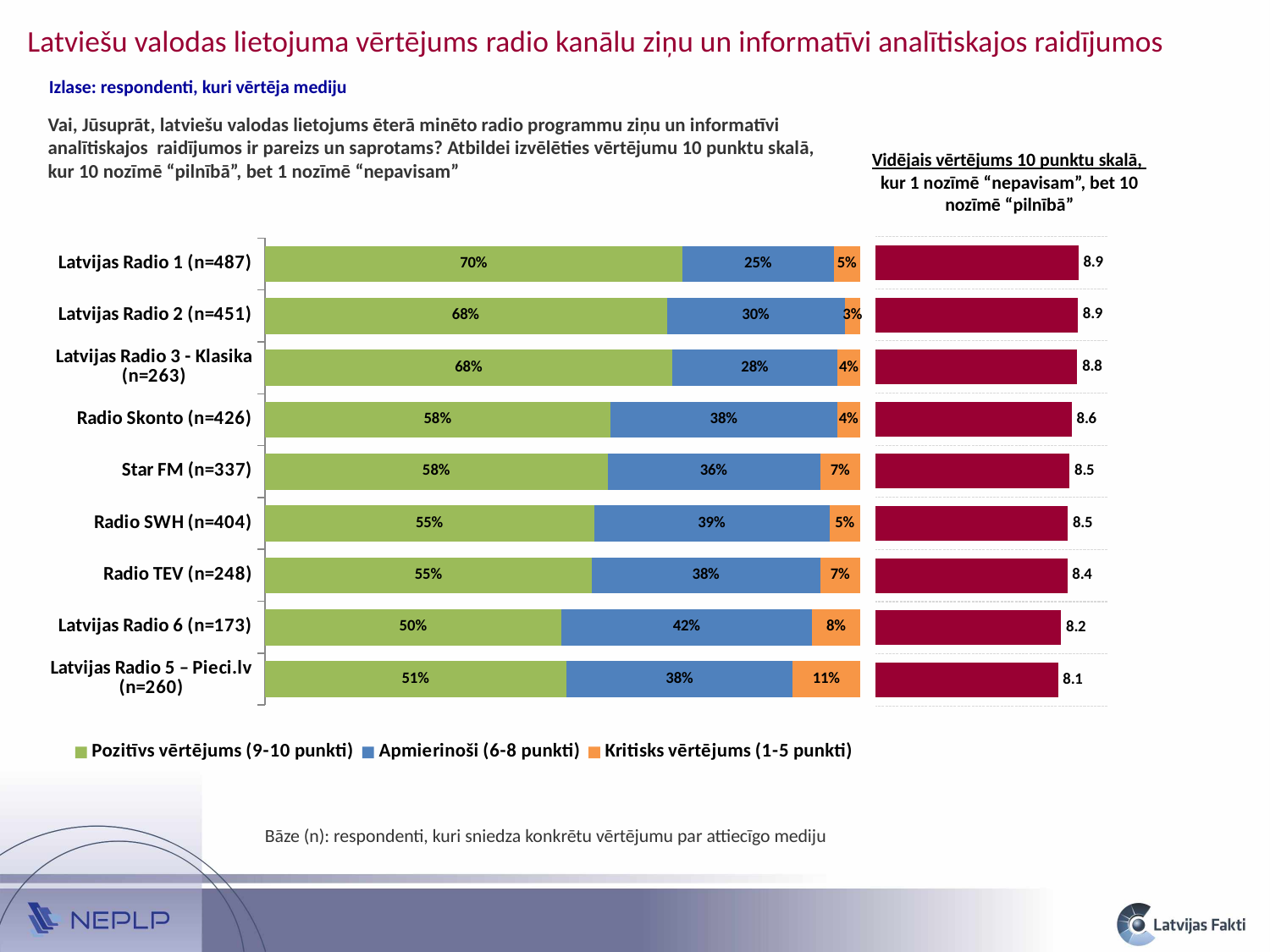
What type of chart is the left chart showing the rating shares? Stacked bar chart In the right chart of average ratings, do the values rise or fall going from Latvijas Radio 1 at the top to Latvijas Radio 5 – Pieci.lv at the bottom? Fall In the right chart of average ratings, which has a higher average rating: Radio TEV (n=248) or Latvijas Radio 3 - Klasika (n=263)? Latvijas Radio 3 - Klasika (n=263) In the left stacked bar chart, what is the critical rating (Kritisks vērtējums, 1-5 punkti) share for Latvijas Radio 5 – Pieci.lv (n=260)? 11% How many series does the legend of the left stacked bar chart list? 3 In the left stacked bar chart, which radio station has the highest share of positive ratings (9-10 punkti)? Latvijas Radio 1 (n=487) In the right chart of average ratings, which radio station has the lowest average rating? Latvijas Radio 5 – Pieci.lv (n=260) In the left stacked bar chart, what percentage of Latvijas Radio 1 (n=487) respondents gave a positive rating (Pozitīvs vērtējums, 9-10 punkti)? 70% In the right chart of average ratings (Vidējais vērtējums 10 punktu skalā), what is the average rating for Radio Skonto (n=426)? 8.6 In the left stacked bar chart, what is the difference between the satisfactory (Apmierinoši, 6-8 punkti) share for Latvijas Radio 6 (n=173) and for Latvijas Radio 1 (n=487)? 17% How many radio stations are listed in the left stacked bar chart? 9 In the left stacked bar chart, what is the total of the three segments for Star FM (n=337)? 101%